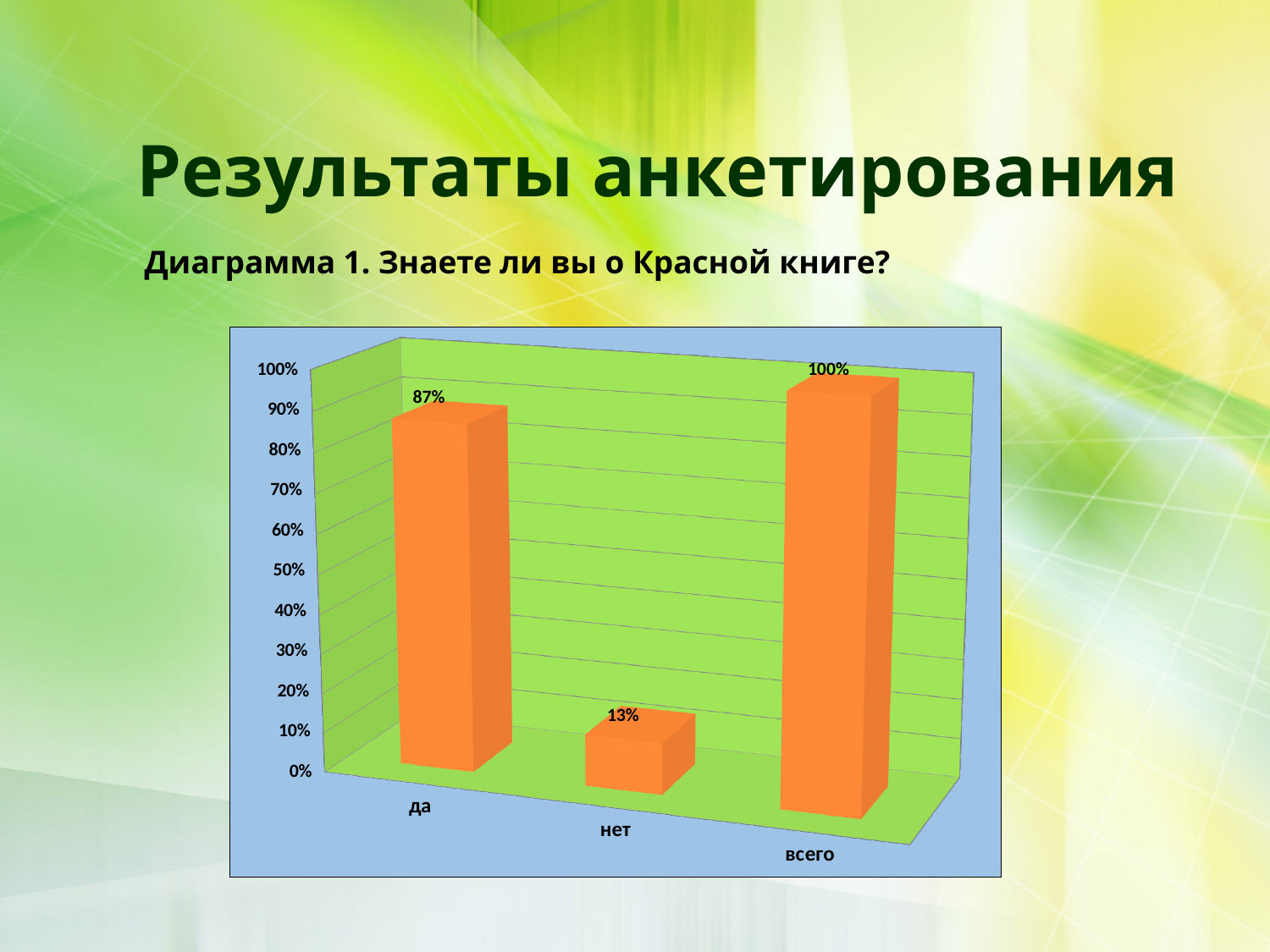
What is the difference between the values for "да" and "нет"? 74% What is the value for "нет"? 13% Is the value for "нет" greater or less than 20%? less What is the value for "всего"? 100% What kind of chart is shown on the slide? bar chart What is the title of the chart as given on the slide? Диаграмма 1. Знаете ли вы о Красной книге? How many categories are shown on the x axis? 3 Which category has the lowest value? нет What is the value for "да"? 87% Which is larger, the value for "да" or the value for "нет"? да Which category has the highest value? всего What colour are the bars in the chart? orange